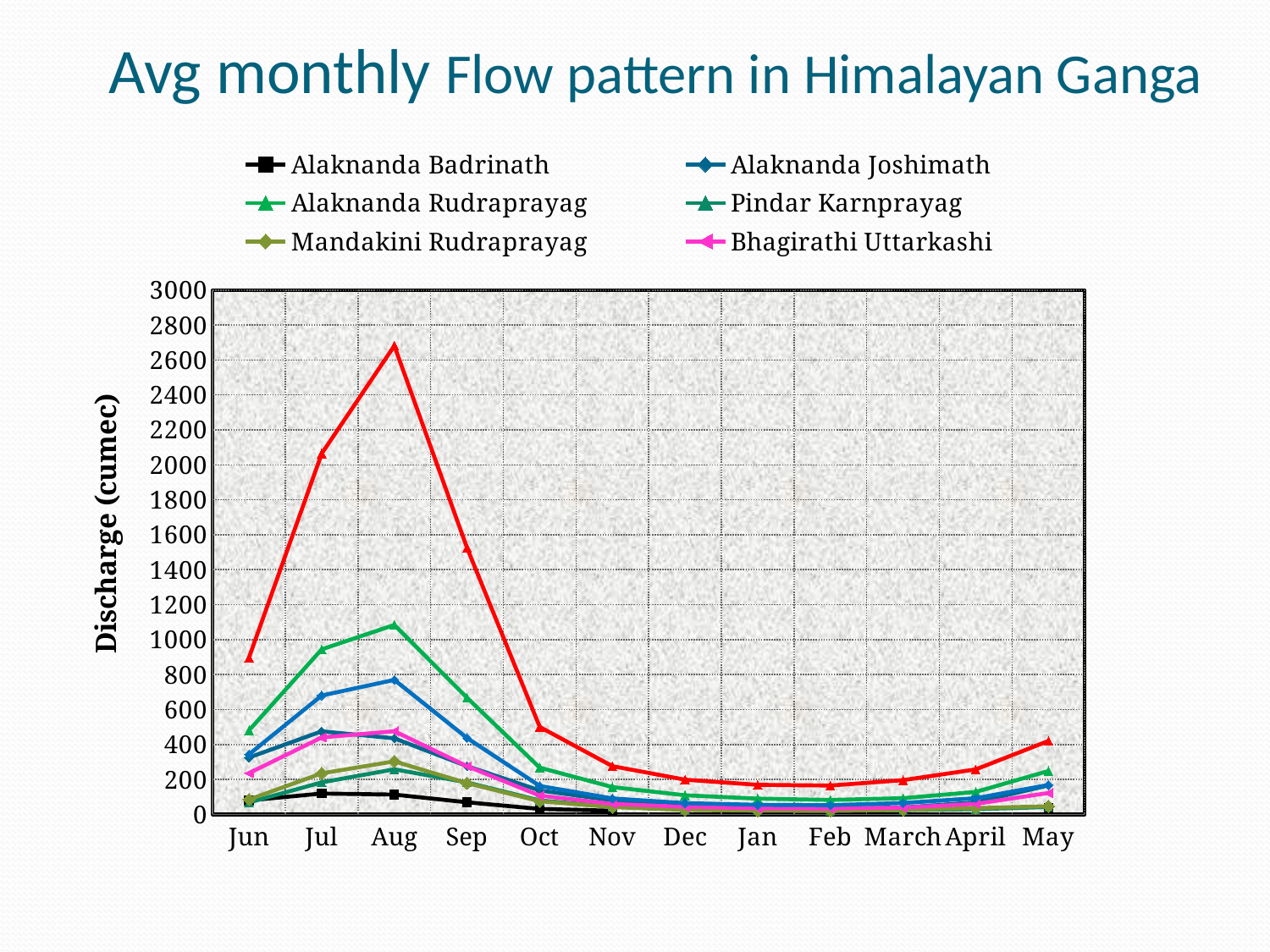
Do the values for Alaknanda Rudraprayag rise or fall from Aug to Nov? fall In which month does the Alaknanda Rudraprayag series reach its highest value? Aug How many series does the legend list? 6 Which is larger in Aug, Alaknanda Rudraprayag or Alaknanda Joshimath? Alaknanda Rudraprayag How many months are shown along the x axis? 12 Is the value for Bhagirathi Uttarkashi in Aug greater or less than 400? greater What is the title of the chart? Avg monthly Flow pattern in Himalayan Ganga Is the value for Alaknanda Badrinath in Jul greater or less than 200? less What is the label of the y axis? Discharge (cumec) What kind of chart is shown on the slide? line chart Is the value for Alaknanda Rudraprayag in Aug greater or less than 1000? greater